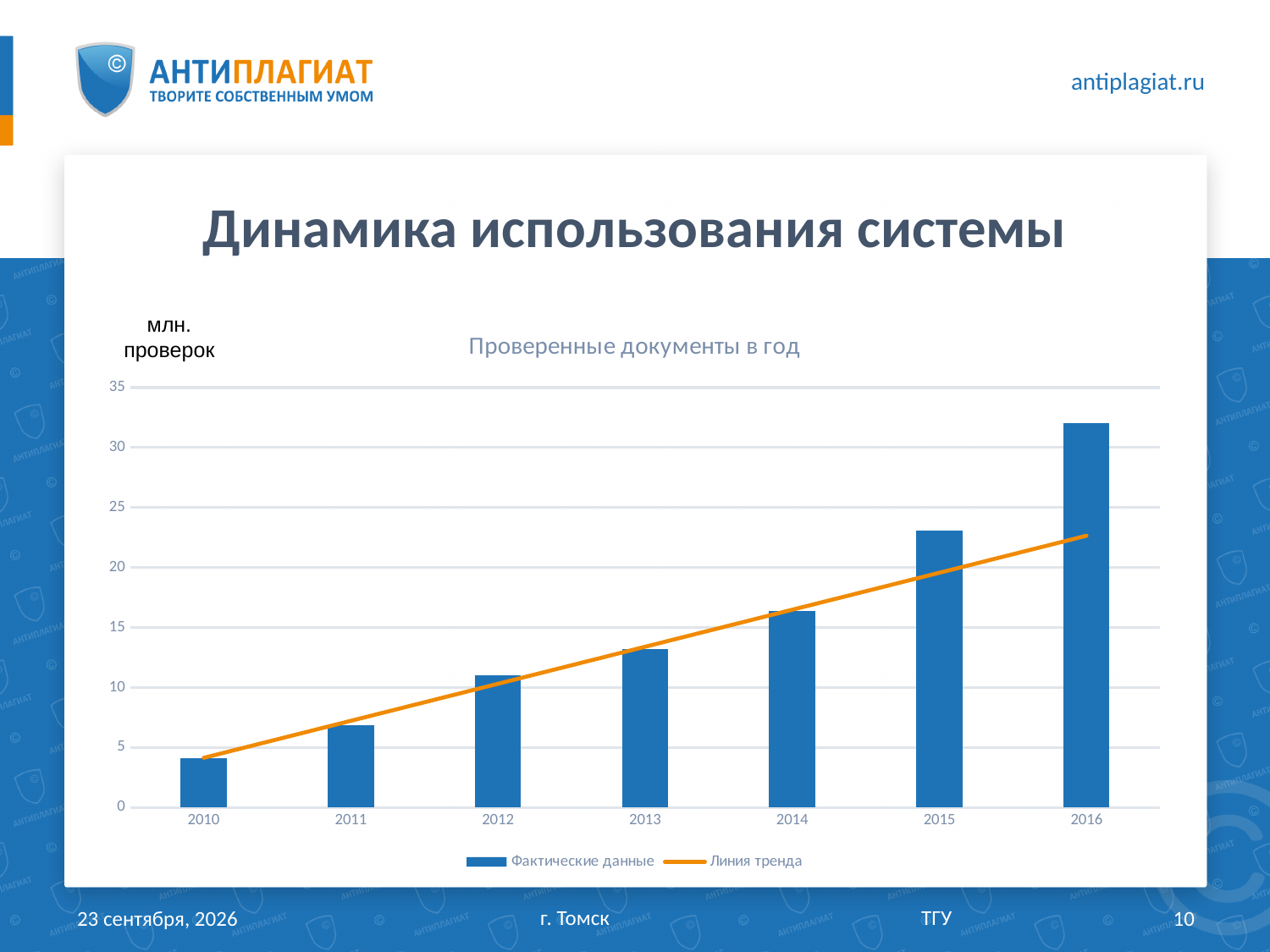
Which year has the highest number of checked documents? 2016 Do the values of the bars rise or fall from 2010 to 2016? rise What unit is indicated on the vertical axis of the chart? млн. проверок Is the value for 2016 greater or less than 30? greater How many series does the chart legend list? 2 What is the title of the chart? Проверенные документы в год Is the value for 2010 greater or less than 5? less How many years are shown on the x axis of the chart? 7 Which year has the lowest number of checked documents? 2010 Which year has the larger value, 2013 or 2015? 2015 Is the value for 2015 greater or less than 20? greater What kind of chart is shown on the slide? bar chart with a trend line